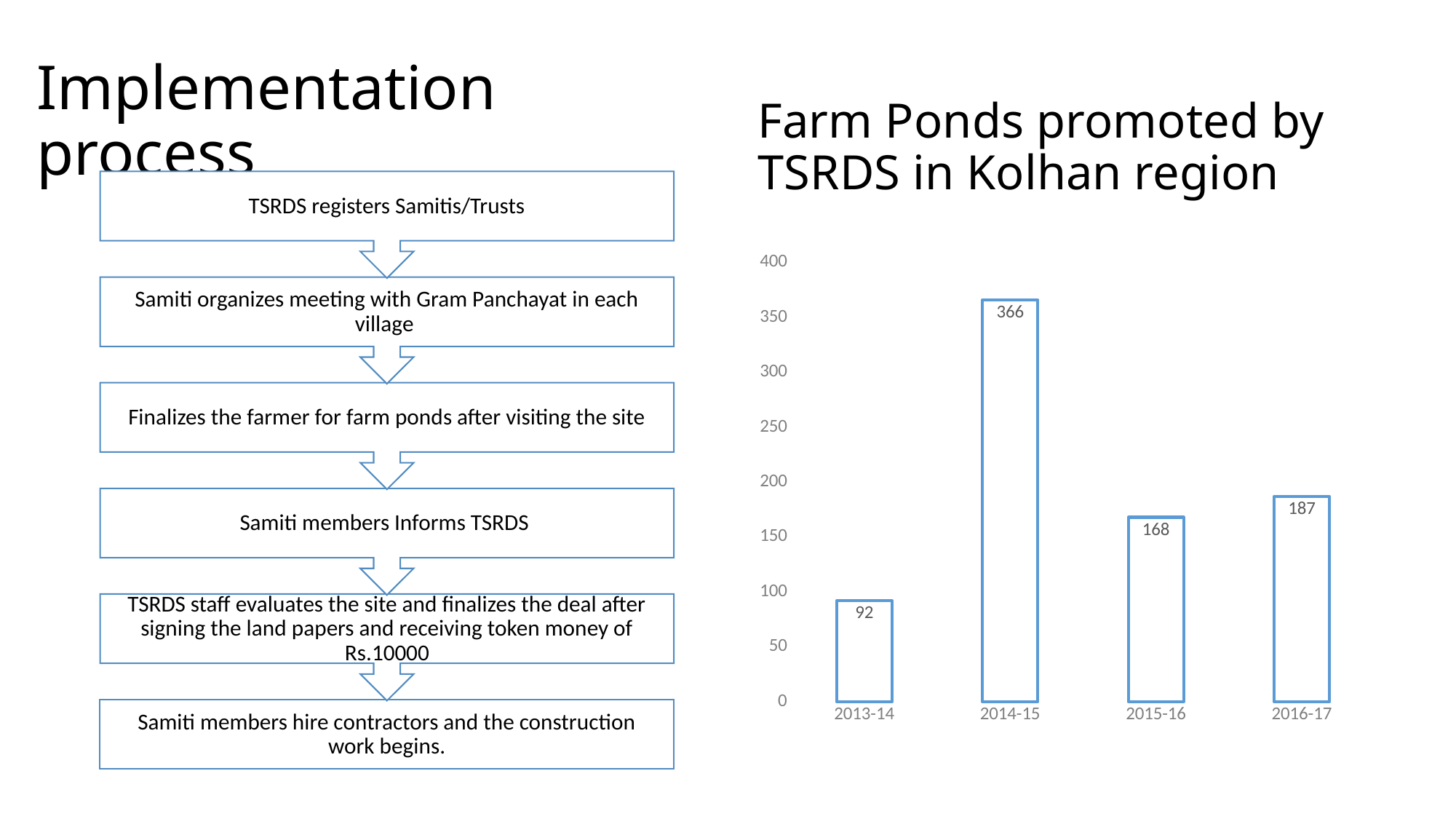
What is the value shown for 2016-17 in the farm ponds chart? 187 Which year has the lowest number of farm ponds promoted? 2013-14 How many farm ponds were promoted by TSRDS in Kolhan region in 2014-15? 366 Which year had more farm ponds promoted, 2015-16 or 2016-17? 2016-17 What is the difference between the values for 2016-17 and 2013-14? 95 How many years are shown on the x axis of the farm ponds chart? 4 What is the value shown for 2013-14 in the farm ponds chart? 92 Which year has the highest number of farm ponds promoted? 2014-15 What is the difference between the farm ponds promoted in 2014-15 and 2015-16? 198 What is the title of the chart on the right side of the slide? Farm Ponds promoted by TSRDS in Kolhan region What kind of chart is used to show farm ponds promoted by TSRDS in Kolhan region? bar chart Is the value for 2015-16 greater or less than 200? less